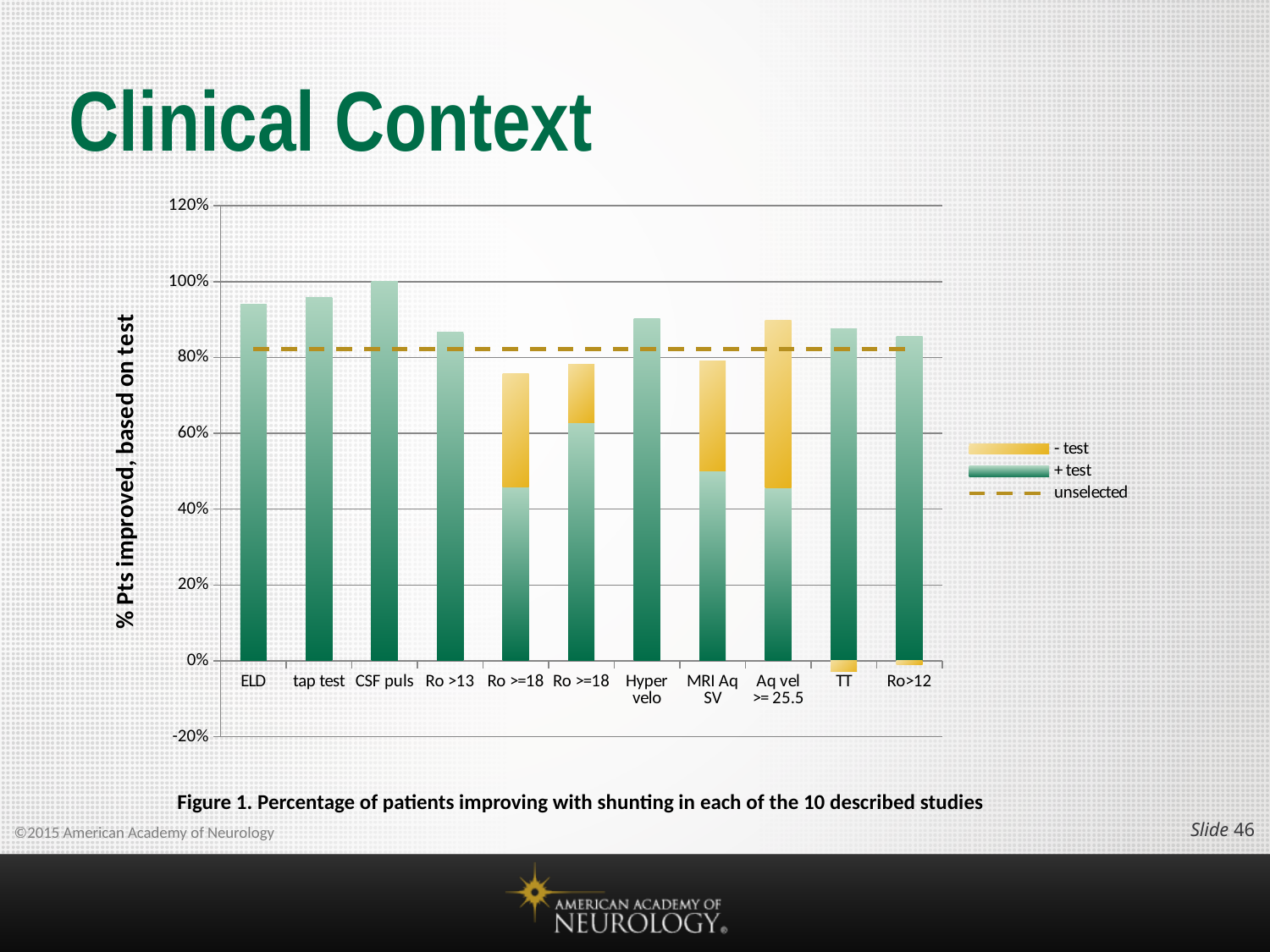
Which is larger, the value for tap test or the value for Hyper velo? tap test What is the title of the y axis? % Pts improved, based on test Is the total value for Aq vel >= 25.5 greater or less than 80%? greater Is the + test value for MRI Aq SV greater or less than 60%? less How many categories are shown along the x axis? 11 Which category has the highest + test value? CSF puls How many entries does the legend list? 3 What does the dashed horizontal line represent according to the legend? unselected Which is larger, the value for ELD or the value for Ro >13? ELD Is the value for ELD greater or less than 80%? greater What kind of chart is shown on the slide? bar chart